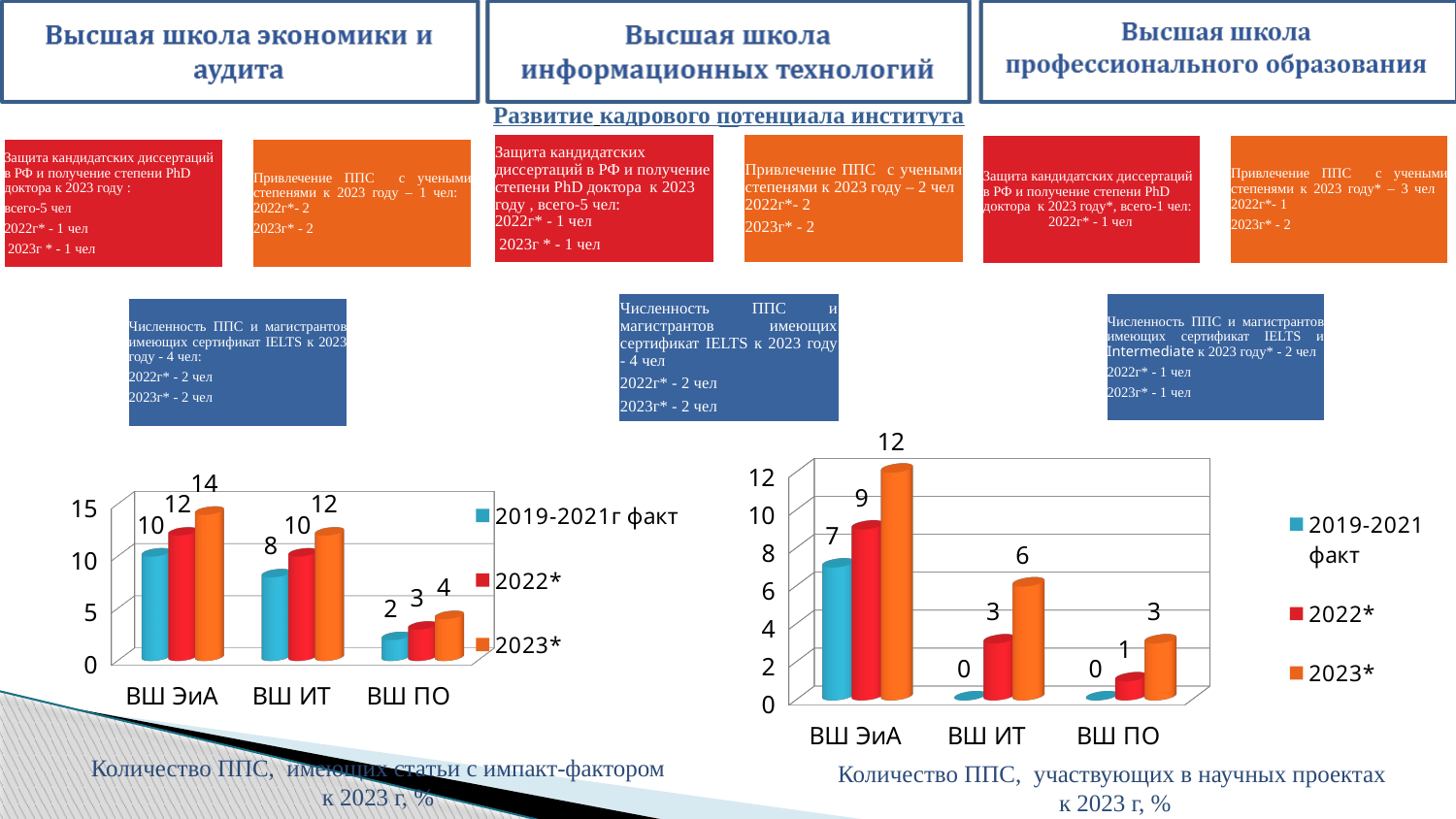
In the right chart (Количество ППС, участвующих в научных проектах), what is the value for ВШ ИТ in the 2019-2021 факт series? 0 In the right chart (Количество ППС, участвующих в научных проектах), how many categories are shown on the x axis? 3 In the left chart (Количество ППС, имеющих статьи с импакт-фактором), which category has the lowest value in the 2022* series? ВШ ПО In the right chart (Количество ППС, участвующих в научных проектах), which is larger: the 2022* value for ВШ ЭиА or the 2023* value for ВШ ИТ? 2022* value for ВШ ЭиА In the left chart (Количество ППС, имеющих статьи с импакт-фактором), what is the value for ВШ ИТ in the 2019-2021г факт series? 8 What kind of chart is the left chart (Количество ППС, имеющих статьи с импакт-фактором)? Bar chart In the left chart (Количество ППС, имеющих статьи с импакт-фактором), what is the value for ВШ ЭиА in the 2023* series? 14 In the left chart (Количество ППС, имеющих статьи с импакт-фактором), how many series does the legend list? 3 In the right chart (Количество ППС, участвующих в научных проектах), which category has the highest value in the 2022* series? ВШ ЭиА In the right chart (Количество ППС, участвующих в научных проектах), what is the difference between the 2023* values for ВШ ИТ and ВШ ПО? 3 In the left chart (Количество ППС, имеющих статьи с импакт-фактором), what is the difference between the 2023* and 2019-2021г факт values for ВШ ПО? 2 In the right chart (Количество ППС, участвующих в научных проектах), what is the value for ВШ ЭиА in the 2023* series? 12